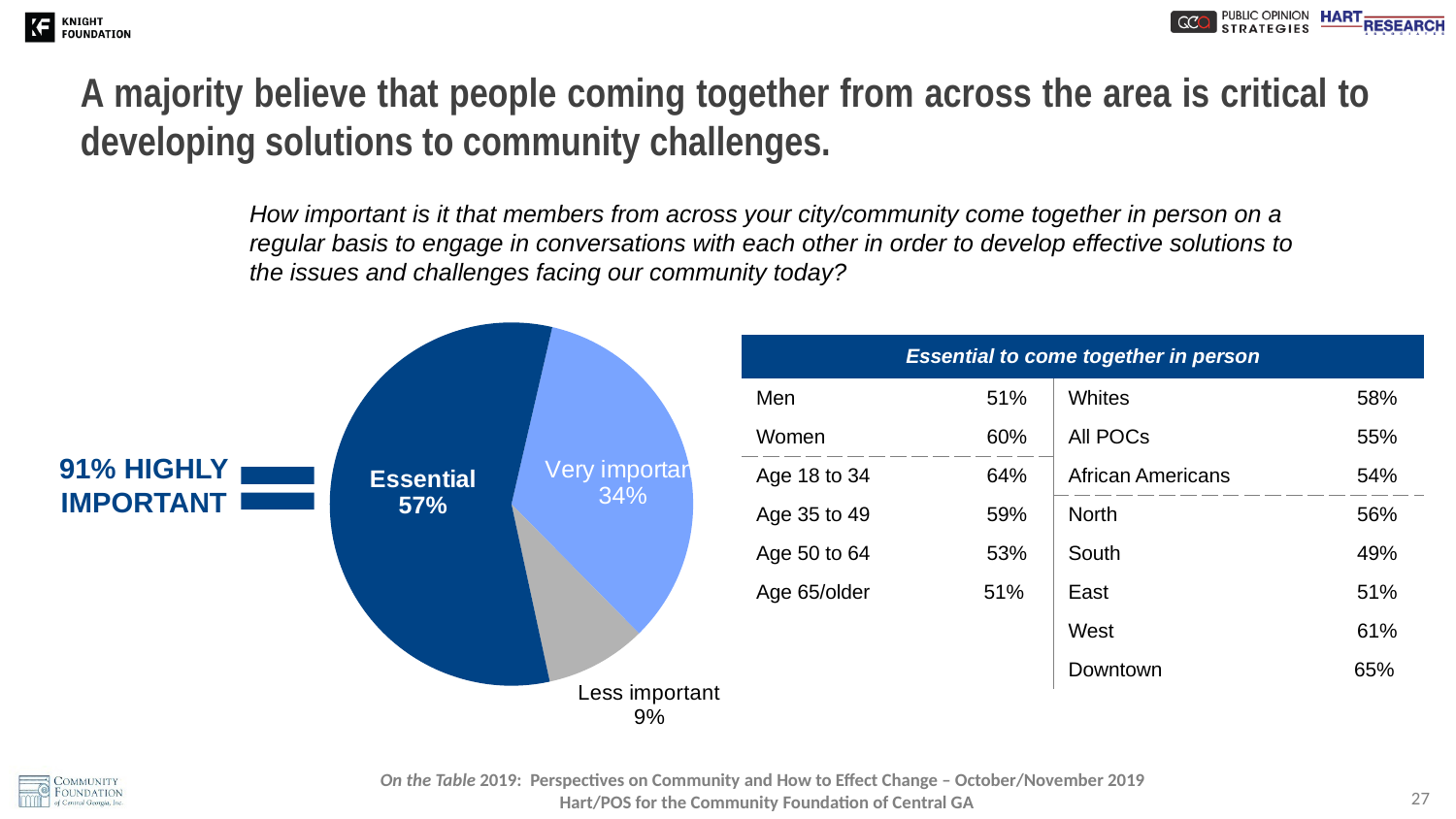
What kind of chart is shown on the slide? pie chart Which slice of the pie chart is the largest? Essential What colour is the Essential slice in the pie chart? dark blue In the pie chart, what percentage say coming together in person is less important? 9% In the pie chart, what is the difference in percentage points between the Very important and Less important slices? 25 percentage points In the pie chart, what do the Essential and Very important slices add up to? 91% How many slices does the pie chart have? 3 In the pie chart, what is the difference in percentage points between the Essential and Very important slices? 23 percentage points In the pie chart, which is larger: the Essential slice or the Very important slice? Essential In the pie chart, what percentage say coming together in person is very important? 34% Which slice of the pie chart is the smallest? Less important In the pie chart, what percentage say it is essential that members come together in person? 57%